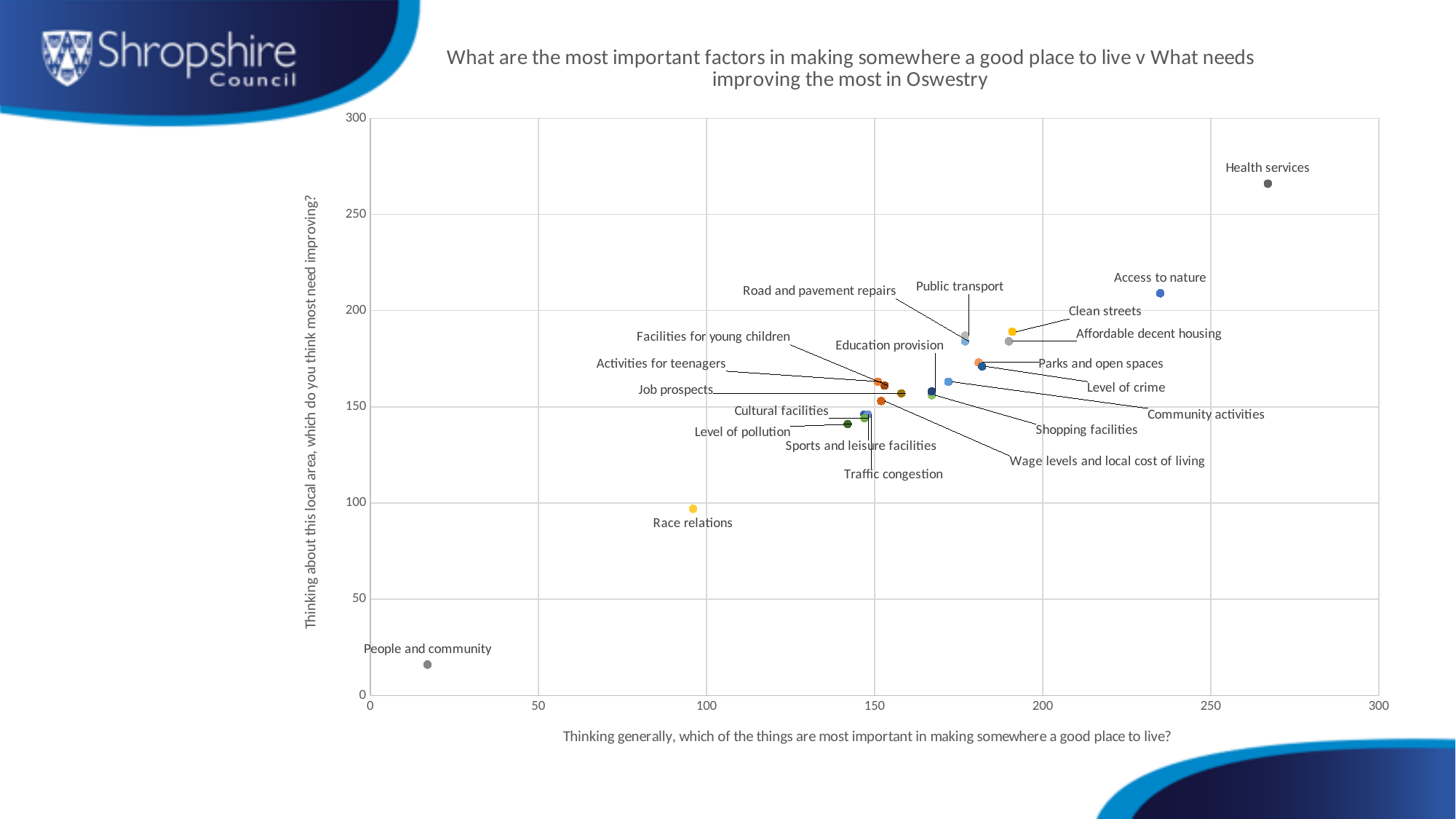
Is the vertical-axis value for Health services greater or less than 250? greater Is the vertical-axis value for Access to nature greater or less than 200? greater What kind of chart is shown on the slide? Scatter chart Is the horizontal-axis value for Race relations greater or less than 100? less Which has a higher horizontal-axis value, Access to nature or People and community? Access to nature What is the title of the horizontal axis? Thinking generally, which of the things are most important in making somewhere a good place to live? Which has a higher vertical-axis value, Health services or Race relations? Health services Which factor has the lowest value on the horizontal axis (most important in making somewhere a good place to live)? People and community Which factor has the highest value on the vertical axis (most need improving)? Health services